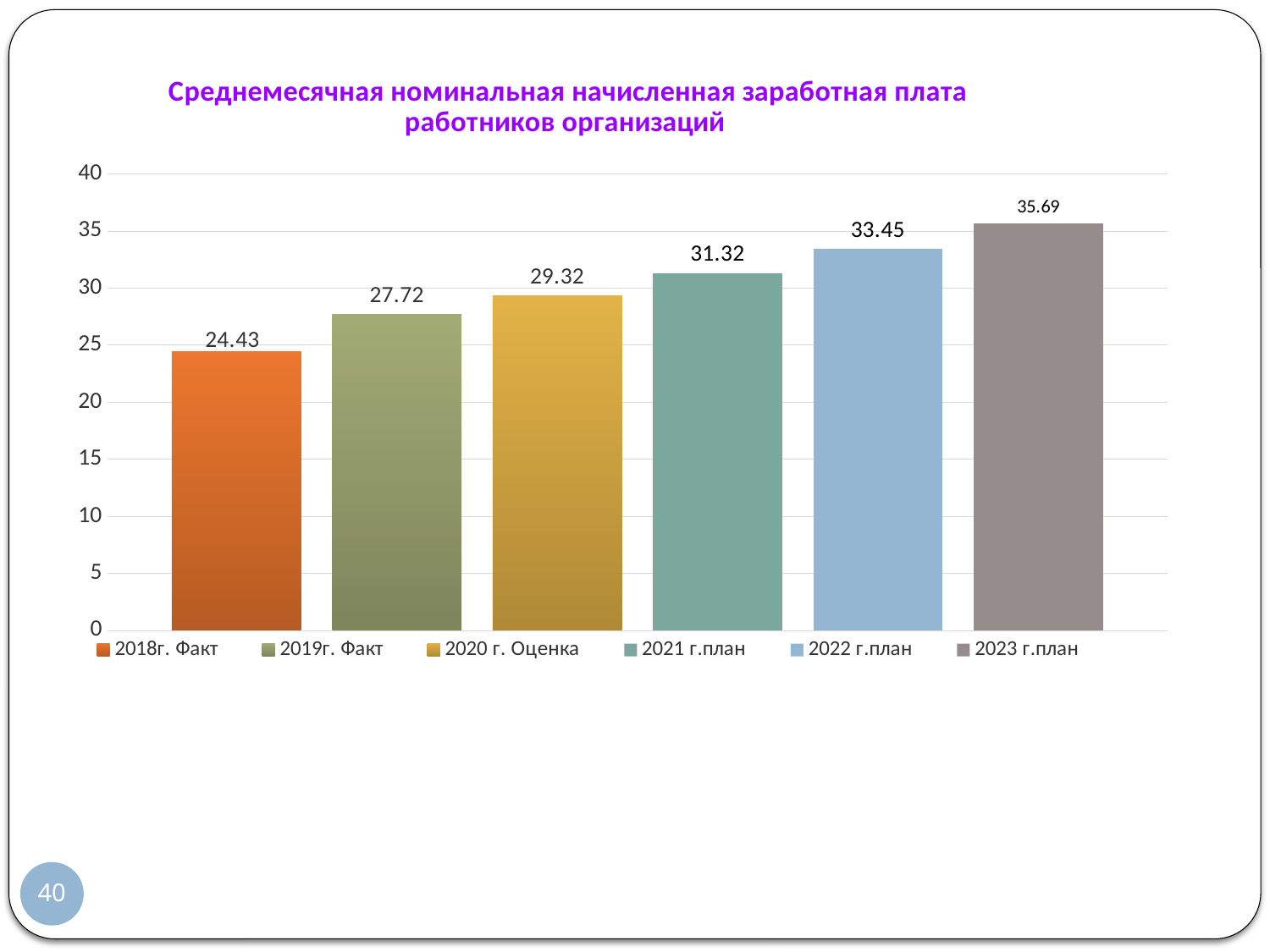
What is the value for 2022 г.план? 33.45 What is the difference between the values for 2021 г.план and 2019г. Факт? 3.6 What kind of chart is shown on the slide? bar chart Which is larger, the value for 2019г. Факт or the value for 2021 г.план? 2021 г.план What is the value for 2018г. Факт? 24.43 What is the value for 2020 г. Оценка? 29.32 How many series does the legend list? 6 What is the difference between the values for 2023 г.план and 2018г. Факт? 11.26 Is the value for 2022 г.план greater or less than 30? greater Which series has the highest value? 2023 г.план Which series has the lowest value? 2018г. Факт Do the values rise or fall from 2018г. Факт to 2023 г.план? rise